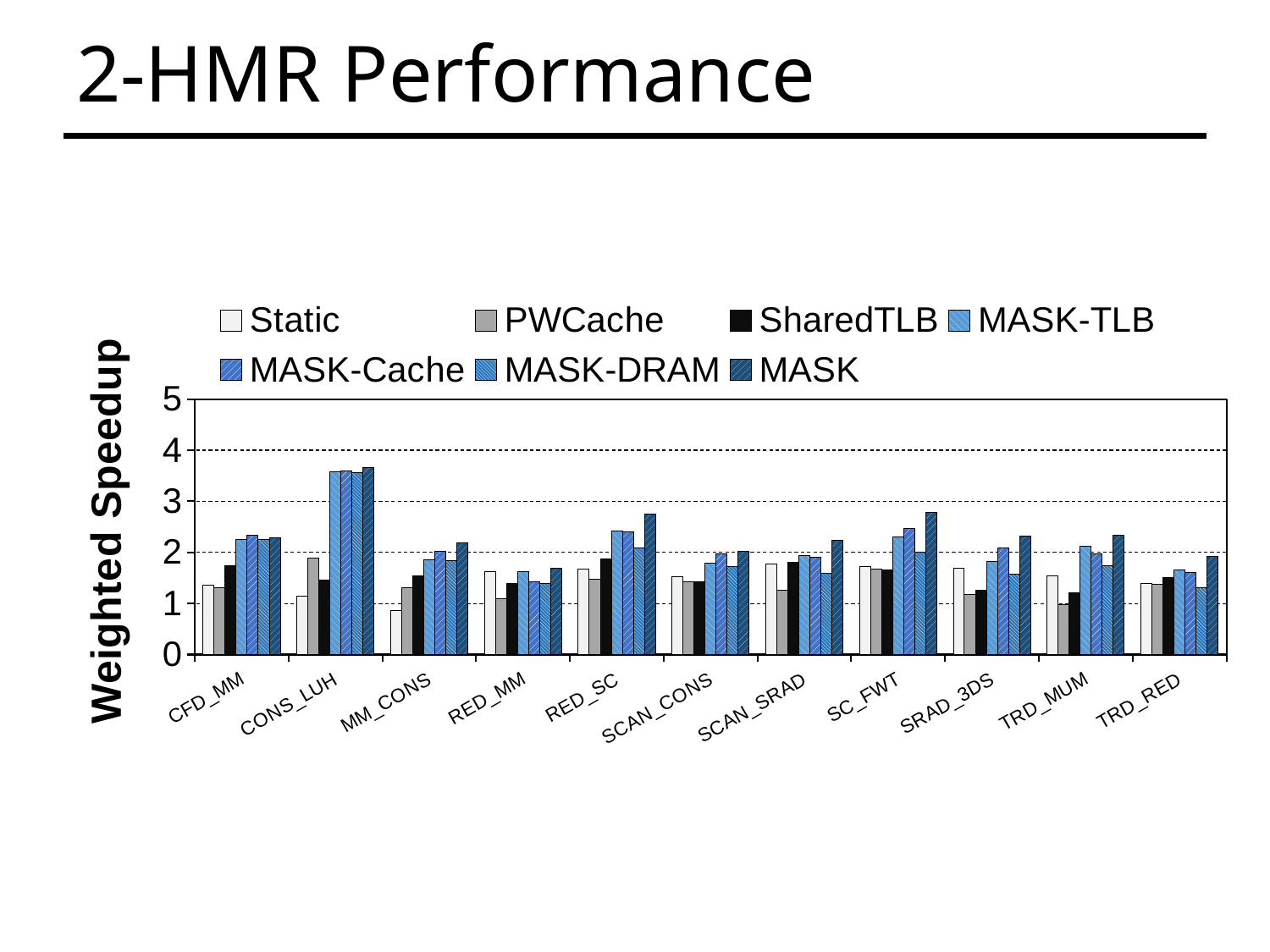
Is the MASK value for CONS_LUH greater or less than 3? greater What is the label of the y axis? Weighted Speedup How many series does the legend list? 7 Which series is listed first in the legend? Static How many workload categories are shown on the x axis? 11 Which is larger: the Static value for RED_MM or the Static value for MM_CONS? RED_MM Is the Static value for MM_CONS greater or less than 1? less For which workload is the Static weighted speedup lowest? MM_CONS Is the MASK value for SC_FWT greater or less than 2? greater What kind of chart is shown on the slide? bar chart For which workload is the MASK weighted speedup highest? CONS_LUH